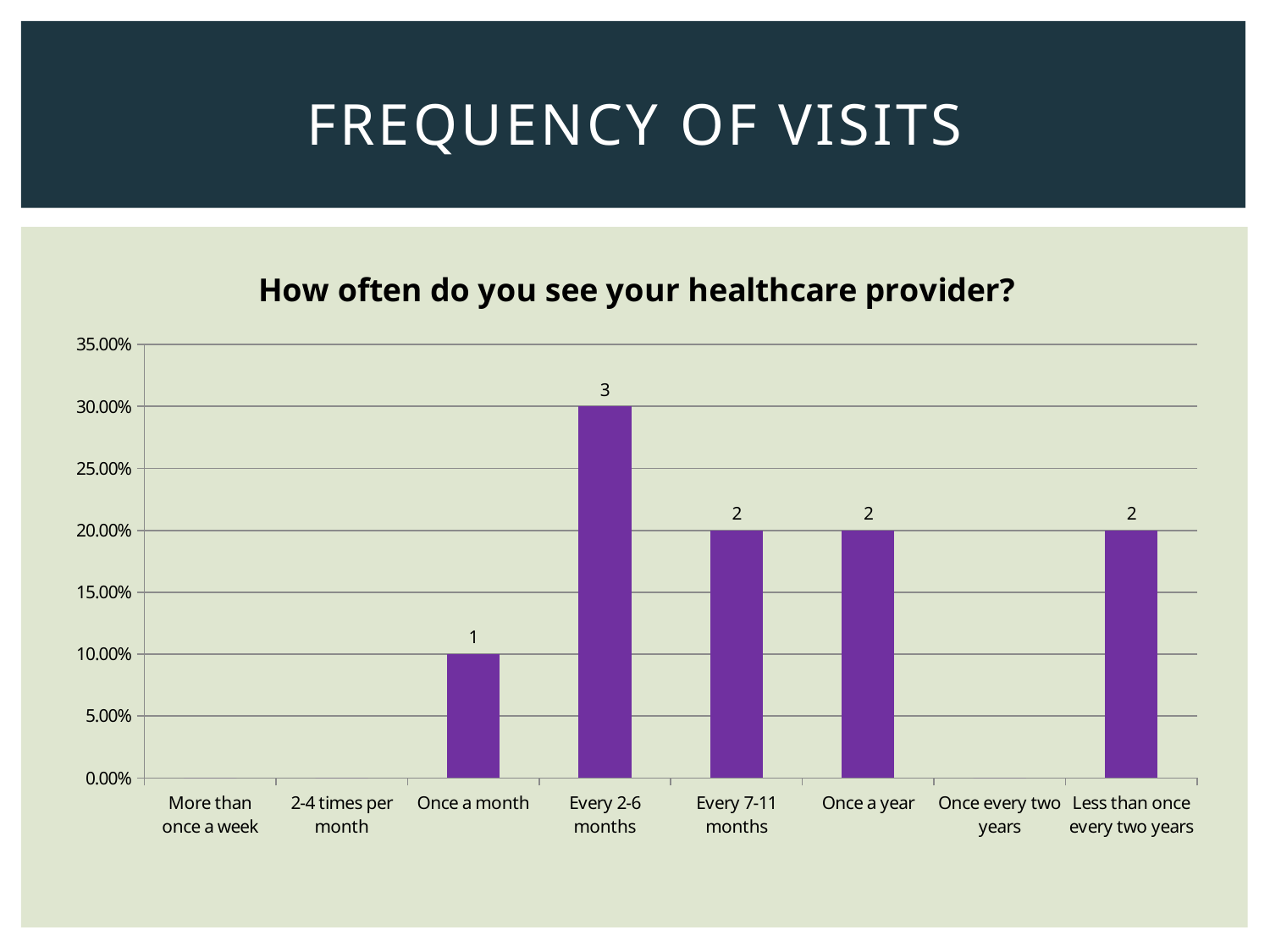
Is the value for "Every 2-6 months" greater or less than 25.00%? greater What data label is printed above the bar for "Every 2-6 months"? 3 What is the title of the chart? How often do you see your healthcare provider? What data label is printed above the bar for "Once a month"? 1 What kind of chart is shown on the slide? bar chart Which category has the highest bar in the chart? Every 2-6 months Which bar is taller: "Once a month" or "Less than once every two years"? Less than once every two years How many categories are listed along the x axis of the chart? 8 What is the difference between the data labels for "Every 2-6 months" and "Once a year"? 1 Among the categories with a visible bar, which has the lowest bar? Once a month How many categories have a visible bar in the chart? 5 What percentage on the y axis does the bar for "Every 7-11 months" reach? 20.00%